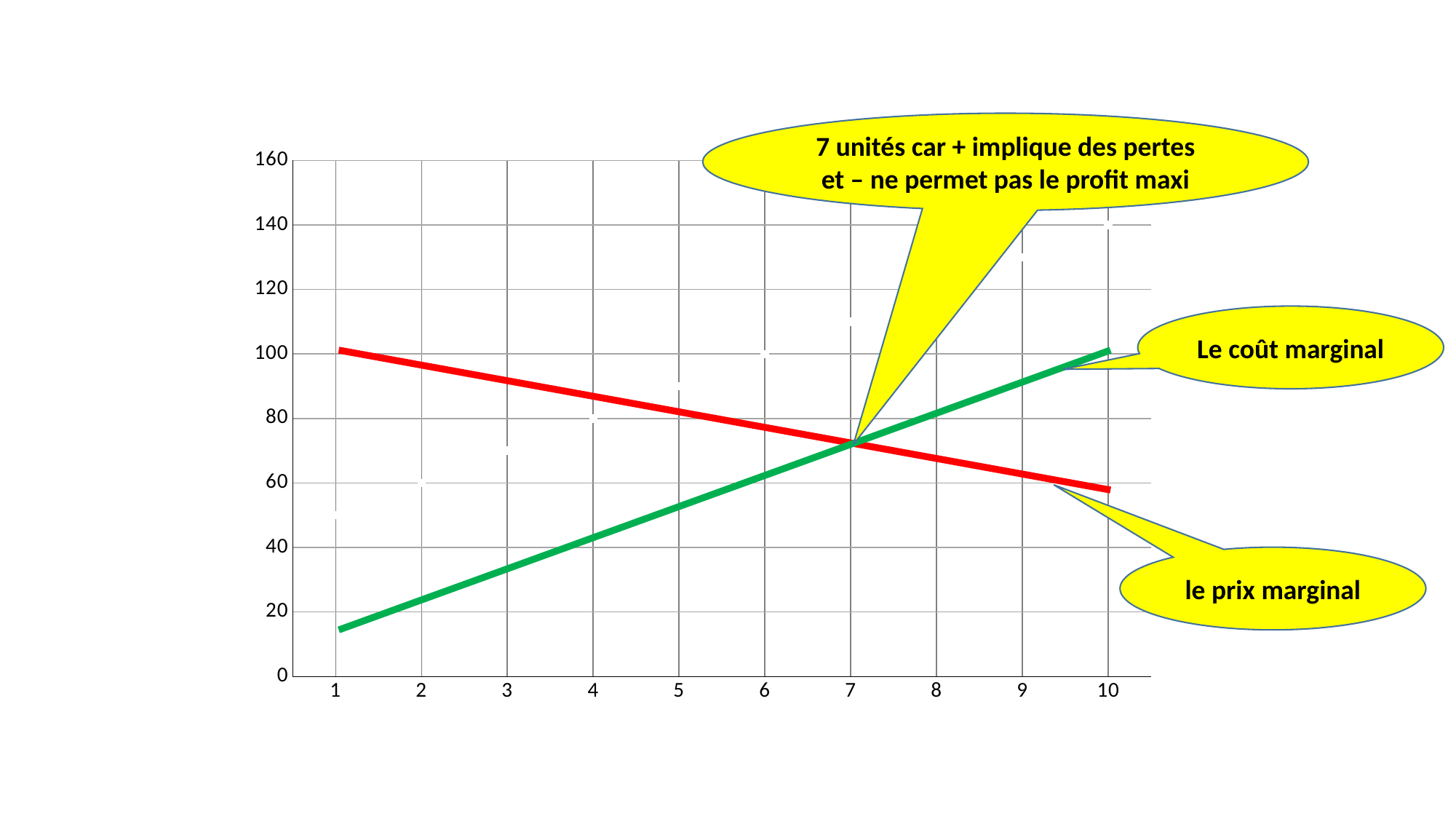
Does the red line (le prix marginal) rise or fall as x increases from 1 to 10? fall At x = 1, which line is higher, the red line (le prix marginal) or the green line (Le coût marginal)? the red line (le prix marginal) Is the value of the green line (Le coût marginal) at x = 1 greater or less than 20? less At which x value do the two lines cross? 7 How many points are marked along the x axis of the chart? 10 Which line does the callout 'Le coût marginal' point to, the red line or the green line? the green line What kind of chart is shown on the slide? line chart Is the value of the green line (Le coût marginal) at x = 4 greater or less than 40? greater Is the value of the red line (le prix marginal) at x = 10 greater or less than 60? less Does the green line (Le coût marginal) rise or fall as x increases from 1 to 10? rise How many lines are plotted on the chart? 2 At x = 10, which line is higher, the red line (le prix marginal) or the green line (Le coût marginal)? the green line (Le coût marginal)